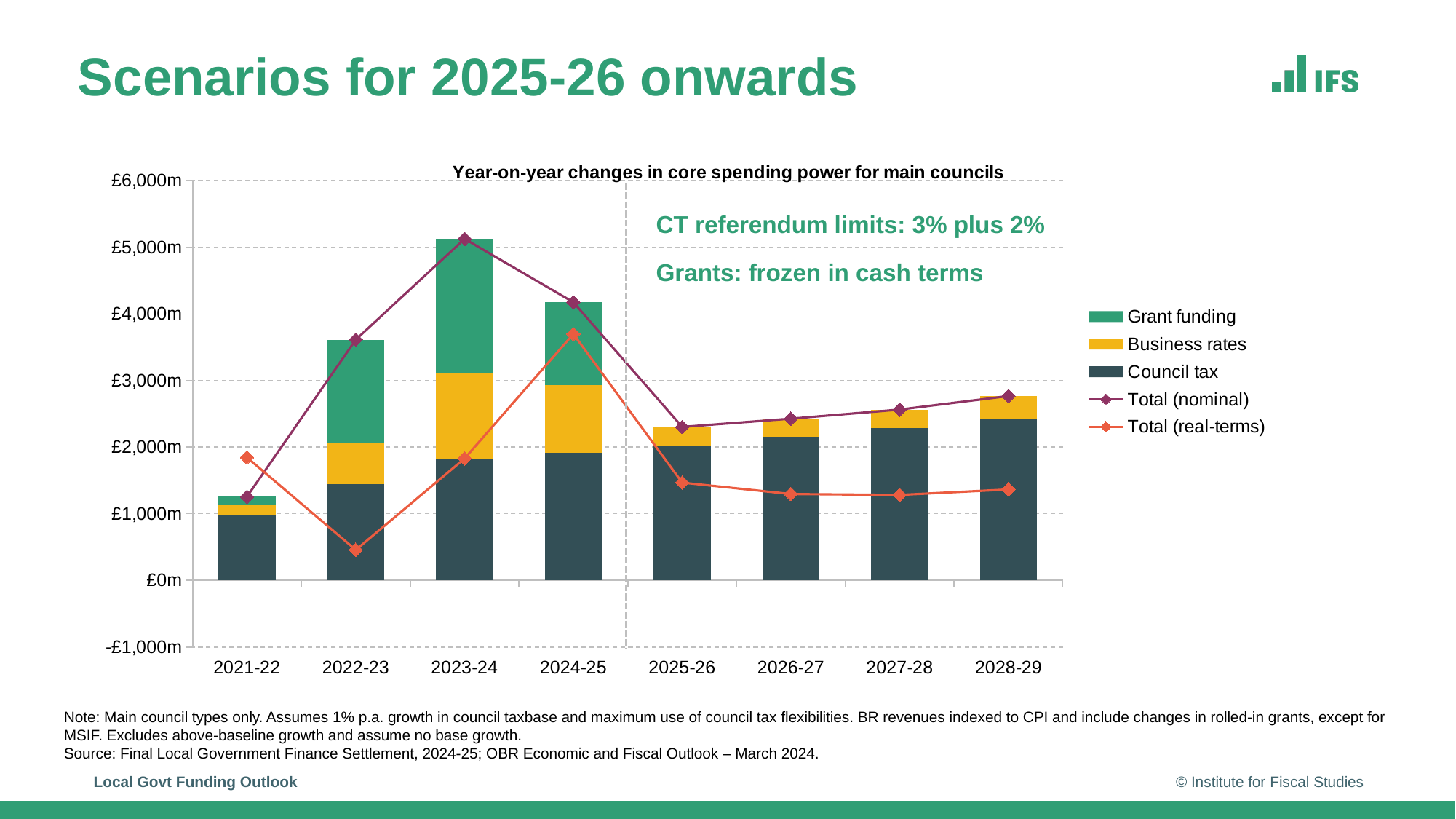
In which year is the Total (real-terms) value lowest? 2022-23 How many years are shown on the x axis of the chart? 8 What is the title of the chart? Year-on-year changes in core spending power for main councils In which year is the Total (real-terms) value highest? 2024-25 Is the Total (nominal) value for 2023-24 greater or less than £5,000m? greater Is the Total (real-terms) value for 2022-23 greater or less than £1,000m? less Does the Total (nominal) line rise or fall from 2025-26 to 2028-29? rise In which year is the Total (nominal) value highest? 2023-24 What kind of chart is this? Stacked bar chart with line series Is the Council tax value for 2028-29 greater or less than £2,000m? greater Which year has the larger Total (nominal) value, 2022-23 or 2024-25? 2024-25 How many series does the chart's legend list? 5